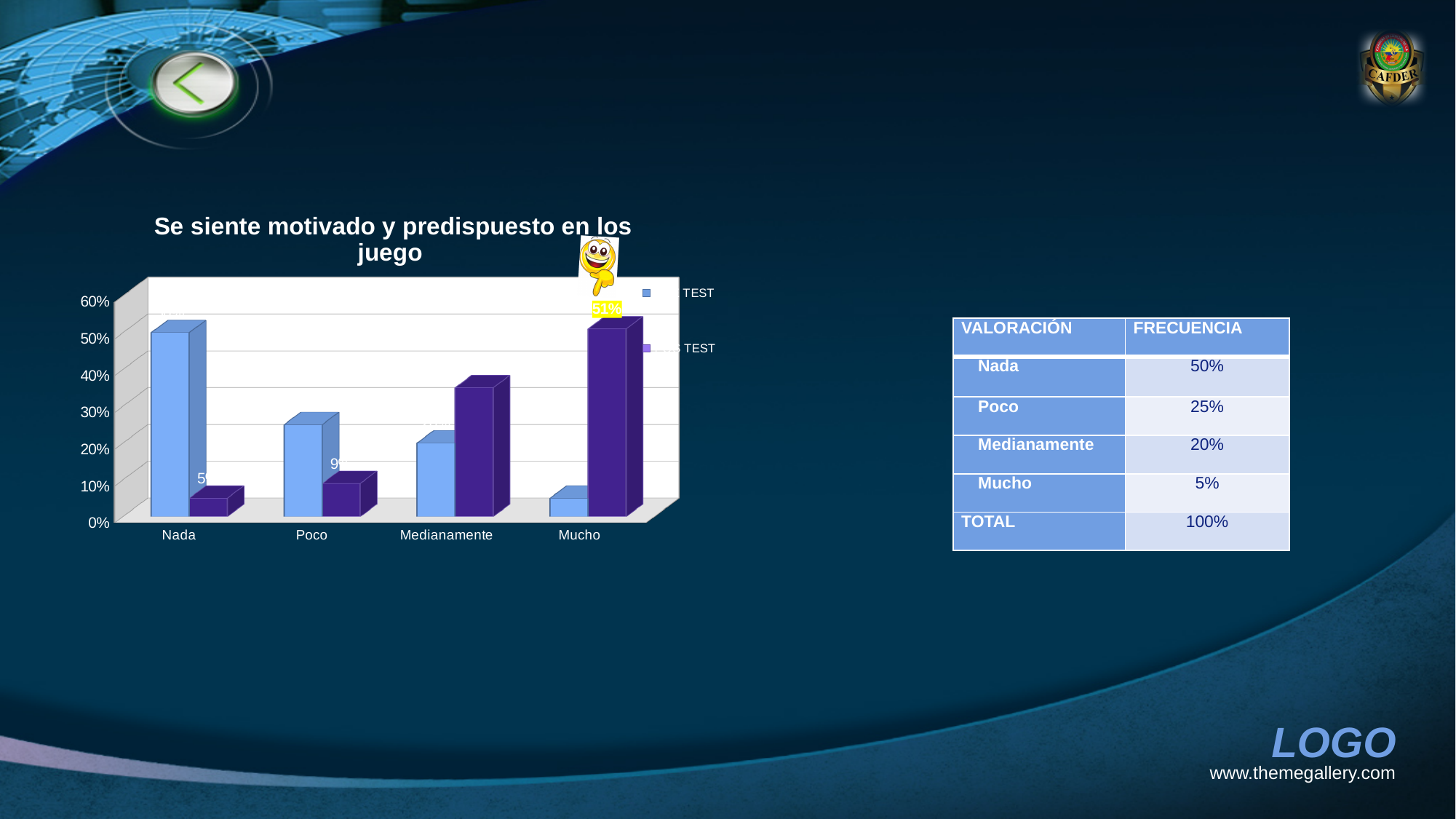
Is the purple bar for Medianamente greater or less than 30%? greater How many categories are shown on the x axis of the chart? 4 What is the value of the purple bar for Mucho? 51% What kind of chart is shown on the slide? bar chart What is the title of the chart? Se siente motivado y predispuesto en los juego Which category has the lowest purple bar? Nada For Nada, which bar is larger, the light blue one or the purple one? light blue Which category has the highest light blue bar? Nada Is the light blue bar for Nada greater or less than 40%? greater Which category has the highest purple bar? Mucho How many series does the chart's legend list? 2 Which category has the lowest light blue bar? Mucho